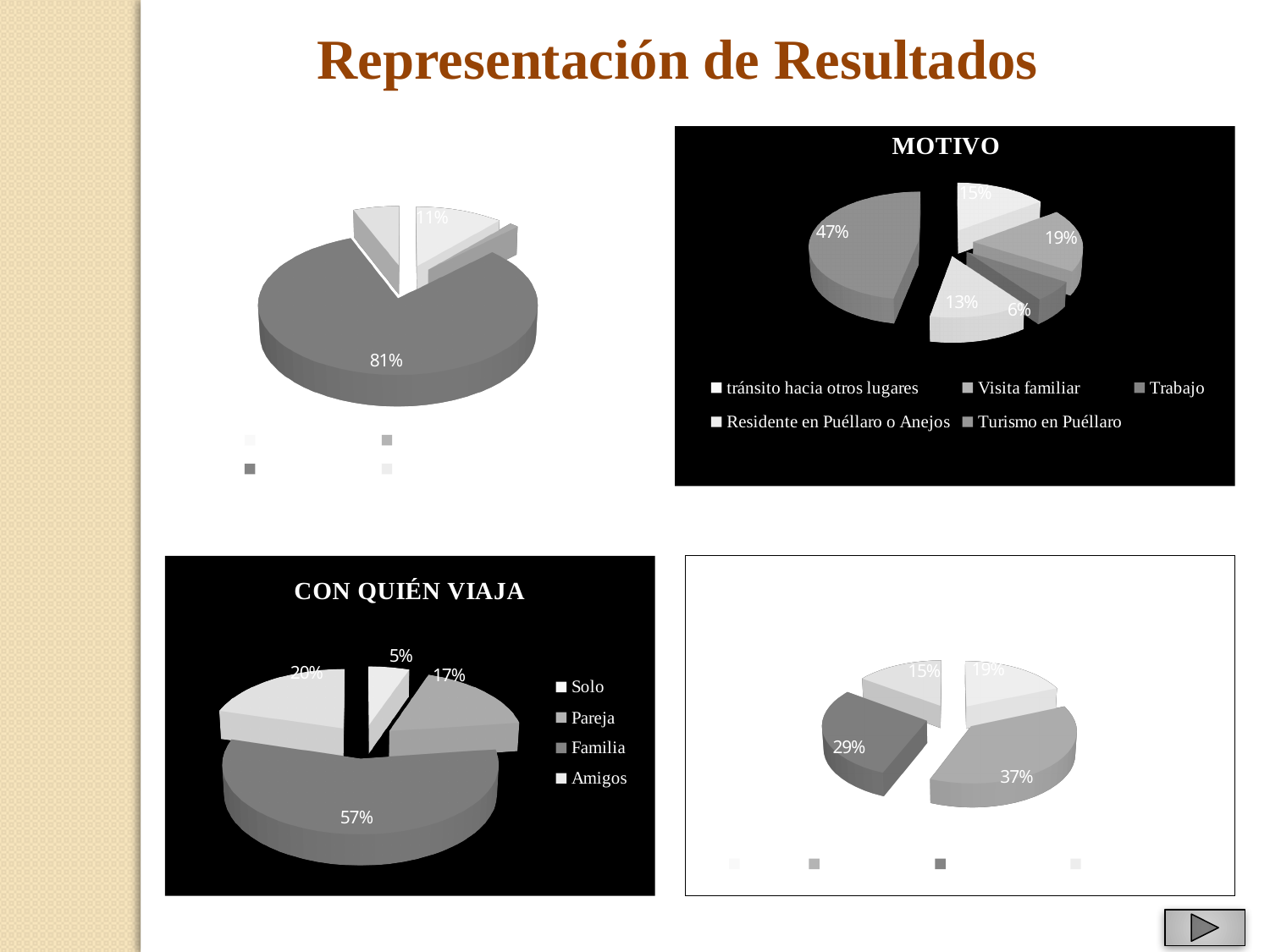
In the top-left pie chart, what is the percentage shown on the largest slice? 81% In the chart titled MOTIVO, what is the smallest percentage shown on any slice? 6% In the chart titled CON QUIÉN VIAJA, what is the smallest percentage shown on any slice? 5% In the chart titled CON QUIÉN VIAJA, which is larger: the slice labelled 20% or the slice labelled 17%? 20% In the chart titled MOTIVO, what is the largest percentage shown on any slice? 47% How many categories does the legend of the chart titled CON QUIÉN VIAJA list? 4 In the chart titled MOTIVO, what is the difference between the largest slice (47%) and the slice labelled 19%? 28% In the bottom-right pie chart, what is the percentage shown on the largest slice? 37% What kind of chart is the chart titled MOTIVO? pie chart What is the title of the chart in the bottom-left of the slide? CON QUIÉN VIAJA How many categories does the legend of the chart titled MOTIVO list? 5